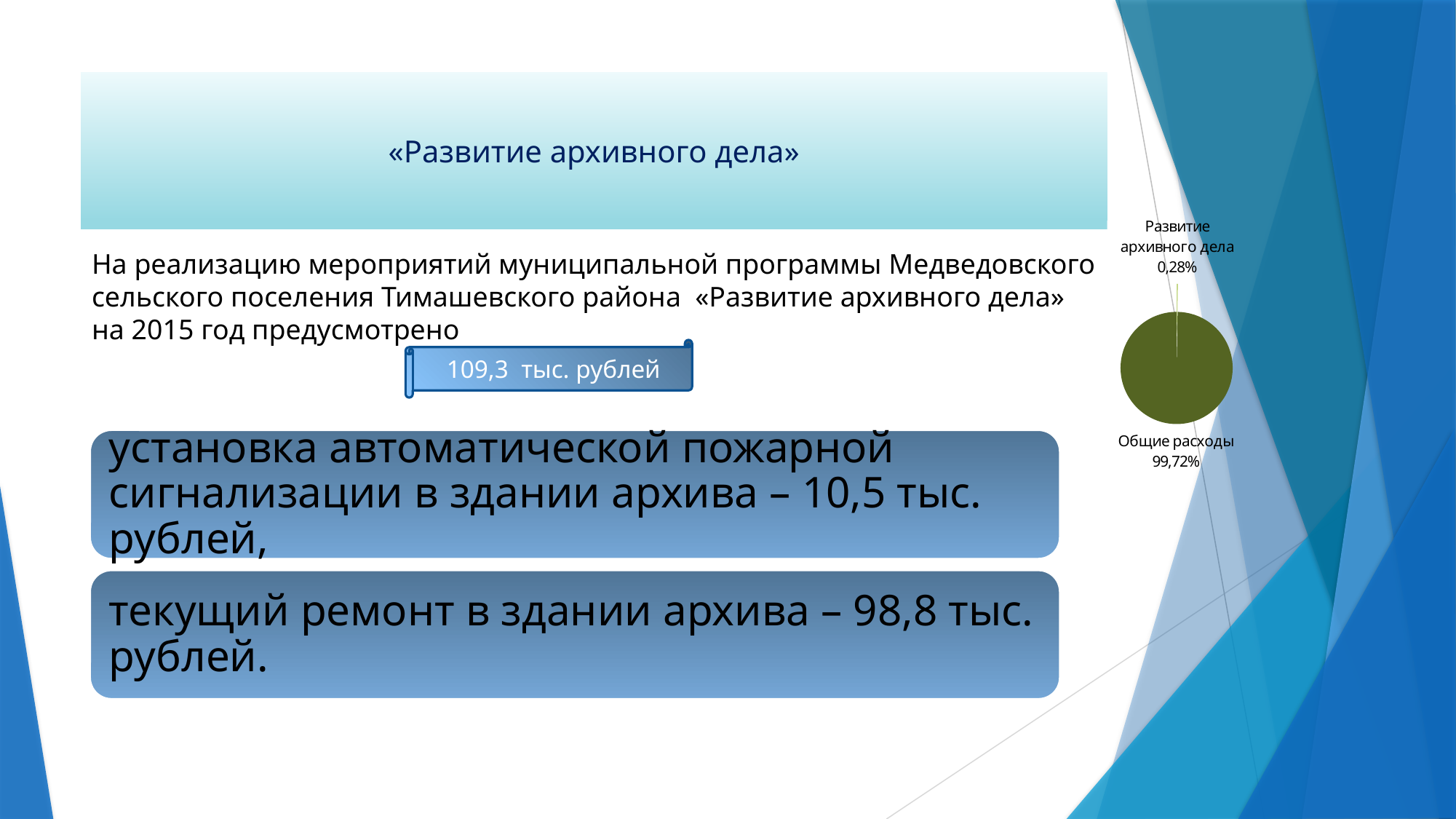
What is the difference in percentage points between the "Общие расходы" slice and the "Развитие архивного дела" slice? 99,44% What colour is the "Общие расходы" slice of the pie chart? olive green Which slice of the pie chart is the smallest? Развитие архивного дела What share of the pie chart does "Развитие архивного дела" represent? 0,28% What share of the pie chart does "Общие расходы" represent? 99,72% In the pie chart, which is larger: "Общие расходы" or "Развитие архивного дела"? Общие расходы How many slices does the pie chart have? 2 What kind of chart is shown on the right side of the slide? pie chart Is the share of "Развитие архивного дела" in the pie chart greater or less than 1%? less Which slice of the pie chart is the largest? Общие расходы